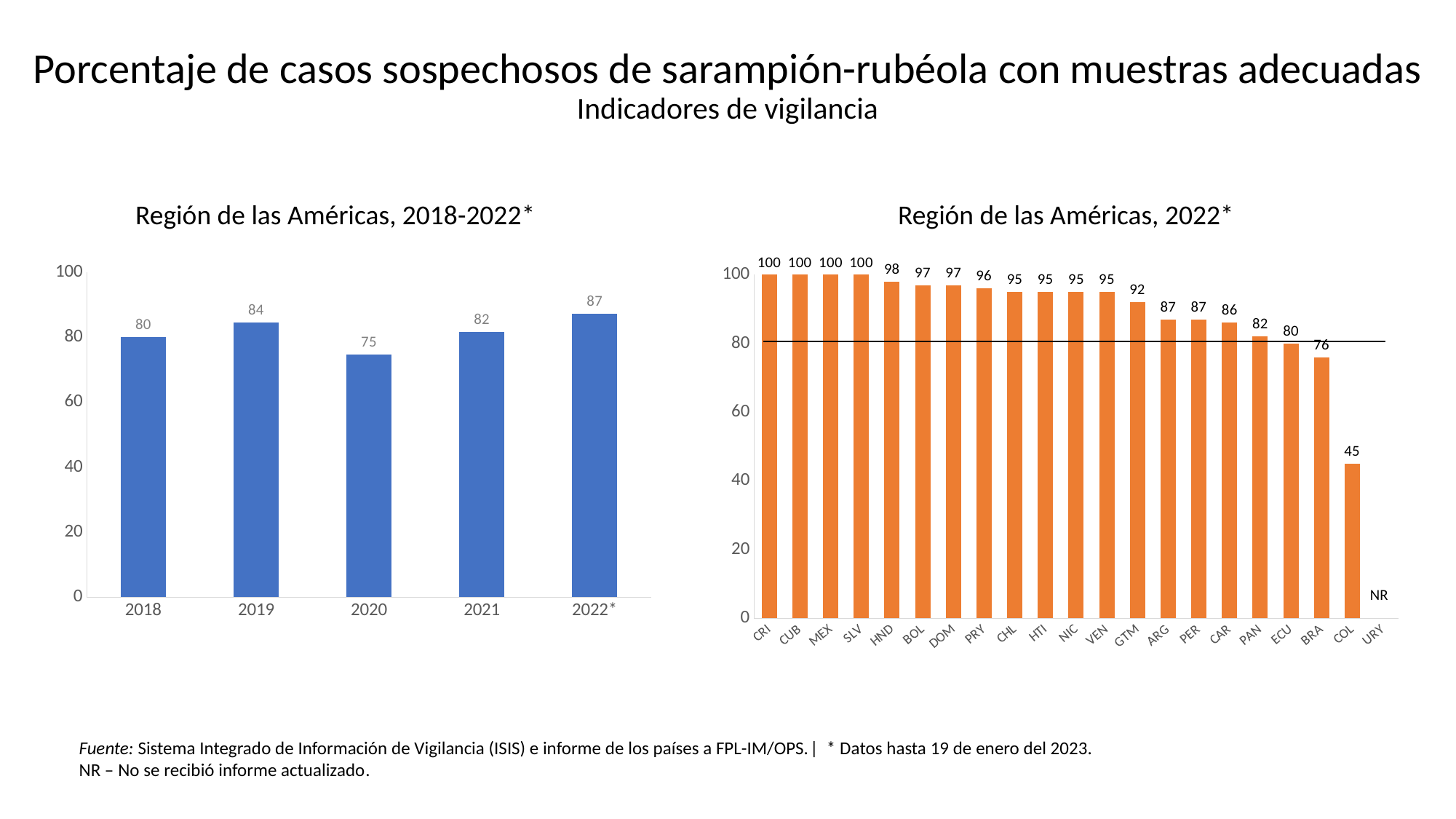
In the chart 'Región de las Américas, 2018-2022*', how many years are shown on the x axis? 5 What kind of chart is 'Región de las Américas, 2018-2022*'? bar chart In the chart 'Región de las Américas, 2018-2022*', which year has the lowest value? 2020 In the chart 'Región de las Américas, 2022*', what is the value for GTM? 92 In the chart 'Región de las Américas, 2018-2022*', which year has the highest value? 2022* In the chart 'Región de las Américas, 2022*', what is the difference between the values for PAN and BRA? 6 In the chart 'Región de las Américas, 2022*', which country has the lowest plotted value? COL In the chart 'Región de las Américas, 2022*', which is larger, the value for HND or the value for BRA? HND In the chart 'Región de las Américas, 2022*', what is the value for COL? 45 In the chart 'Región de las Américas, 2018-2022*', what is the value for 2020? 75 In the chart 'Región de las Américas, 2022*', what label is shown for URY instead of a bar? NR In the chart 'Región de las Américas, 2018-2022*', what is the difference between the values for 2022* and 2018? 7